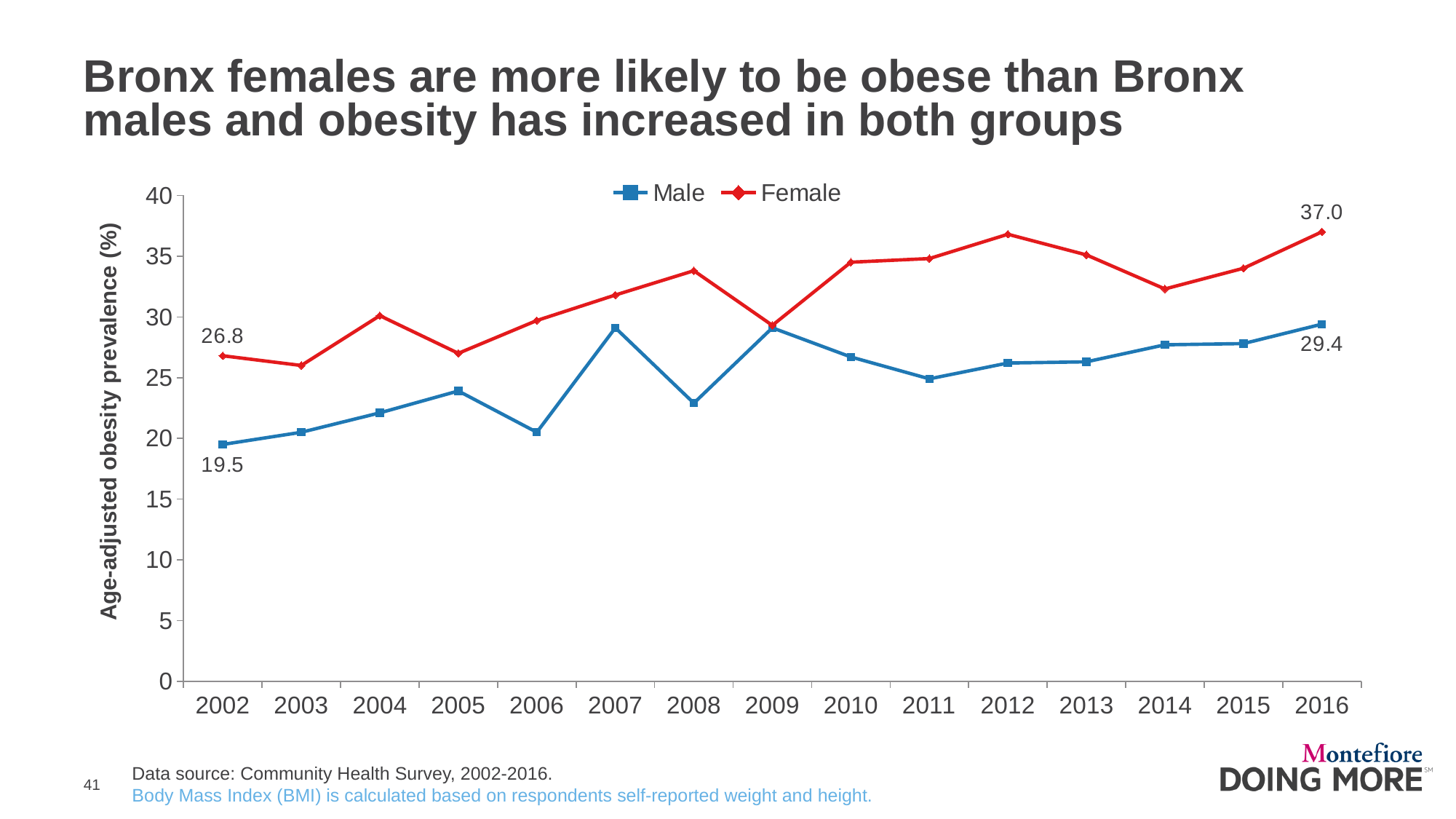
What is the age-adjusted obesity prevalence for Bronx females in 2002? 26.8 What is the age-adjusted obesity prevalence for Bronx males in 2016? 29.4 In 2002, which group had the higher obesity prevalence, males or females? Female Is the male obesity prevalence in 2007 greater or less than 25? greater What kind of chart is shown on the slide? Line chart By how much did the female obesity prevalence increase from 2002 to 2016? 10.2 What is the difference between the female and male obesity prevalence in 2016? 7.6 What is the age-adjusted obesity prevalence for Bronx males in 2002? 19.5 What is the age-adjusted obesity prevalence for Bronx females in 2016? 37.0 How many series does the legend list? 2 Is the female obesity prevalence in 2012 greater or less than 35? greater How many years are shown on the x axis of the chart? 15